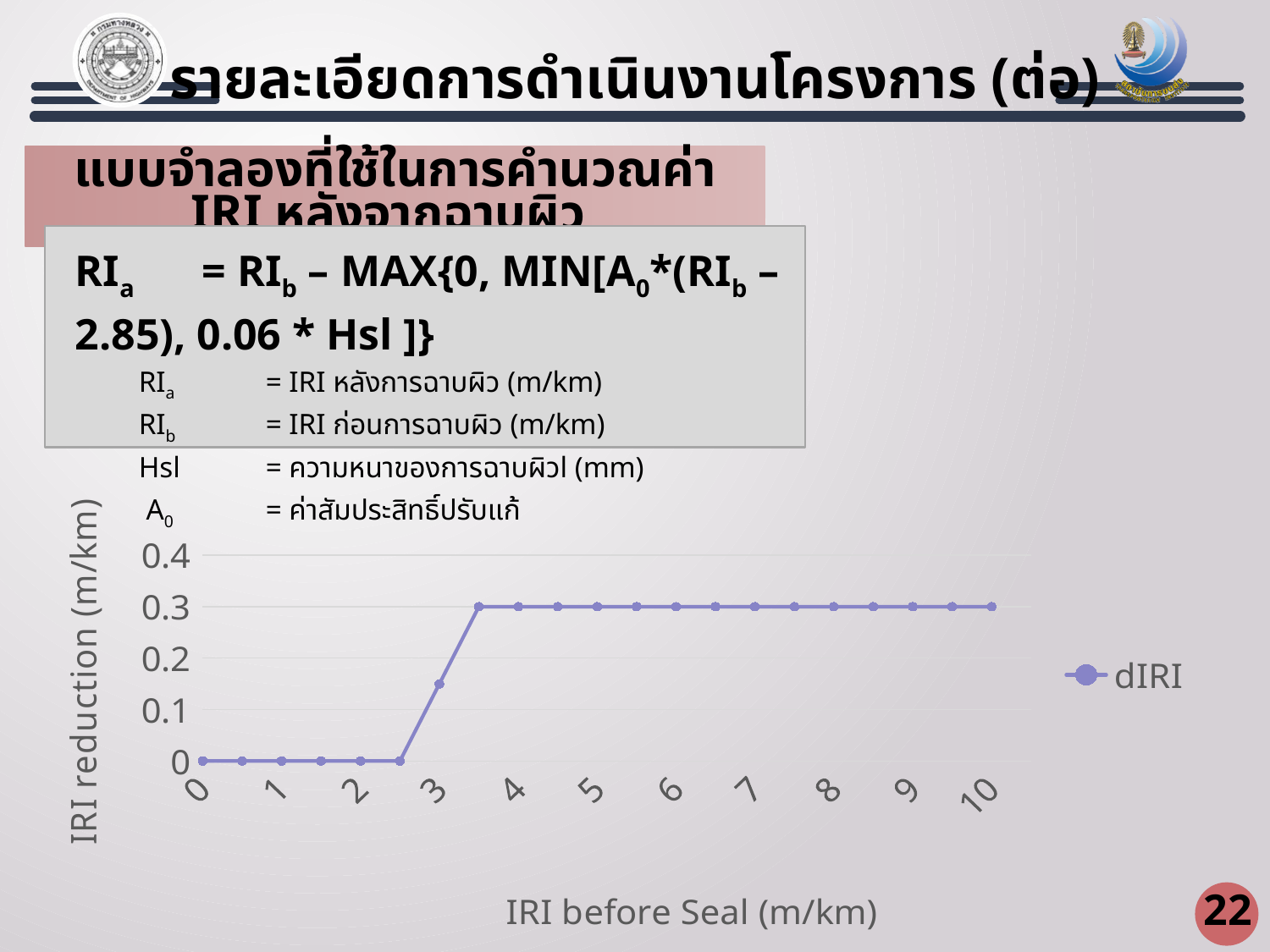
What is the dIRI value when IRI before Seal is 0? 0 What is the name of the series shown in the chart legend? dIRI What is the lowest dIRI value plotted on the chart? 0 What type of chart is shown on the slide? line chart Which has the larger dIRI value: IRI before Seal of 2 or IRI before Seal of 6? 6 What is the highest dIRI value plotted on the chart? 0.3 What is the dIRI value when IRI before Seal is 10? 0.3 What is the label of the x axis of the chart? IRI before Seal (m/km) Is the dIRI value at IRI before Seal of 3 greater or less than 0.2? less What is the dIRI value when IRI before Seal is 5? 0.3 What is the difference between the dIRI value at IRI before Seal of 5 and at IRI before Seal of 1? 0.3 How many series does the chart legend list? 1